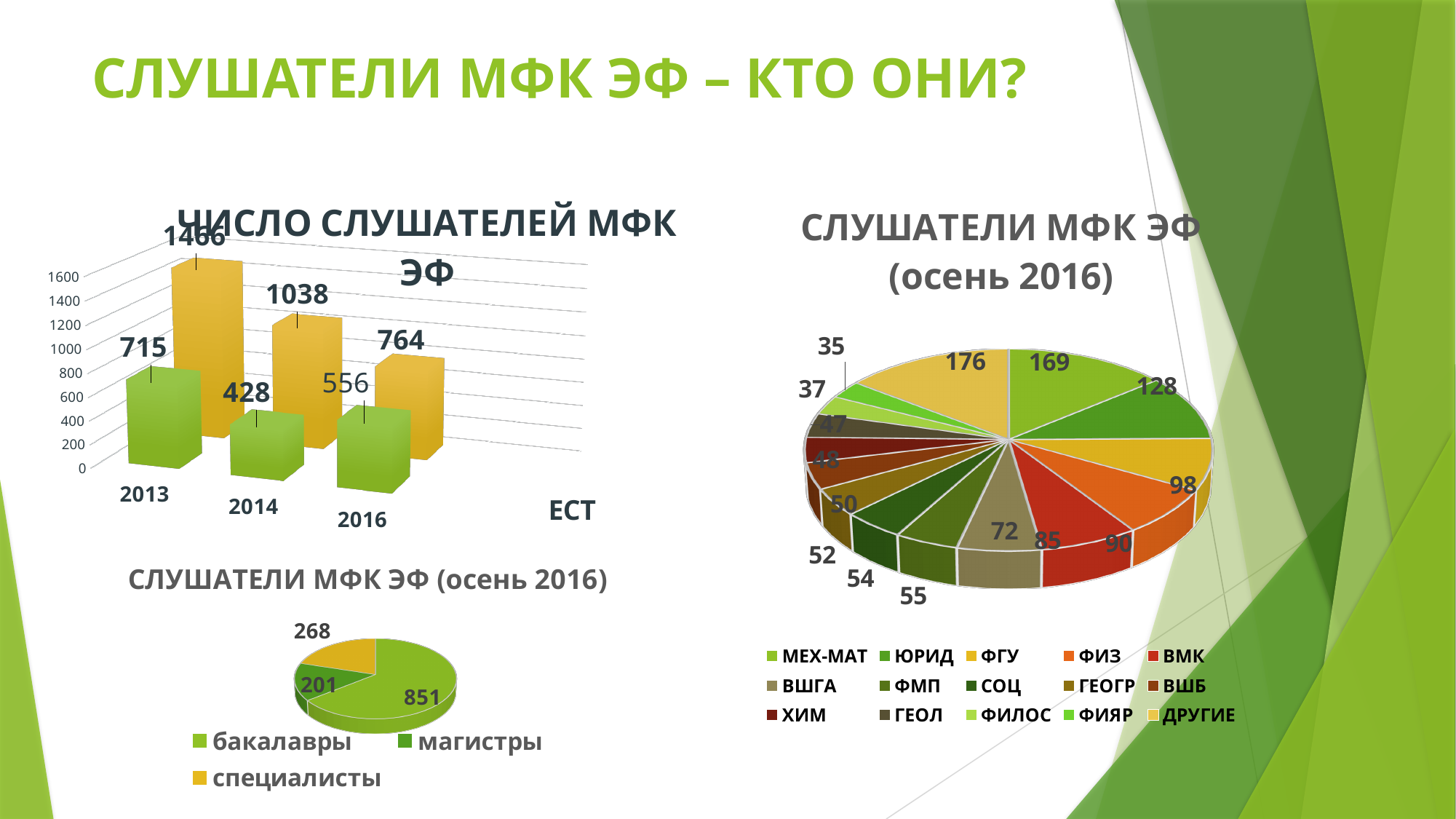
In the large pie chart on the right ('СЛУШАТЕЛИ МФК ЭФ (осень 2016)'), what is the value for МЕХ-МАТ? 169 In the small pie chart at the bottom left, how many categories does the legend list? 3 In the bar chart 'ЧИСЛО СЛУШАТЕЛЕЙ МФК ЭФ', what is the value of the green bar for 2014? 428 In the large pie chart on the right, how many categories does the legend list? 15 In the bar chart 'ЧИСЛО СЛУШАТЕЛЕЙ МФК ЭФ', how many years are shown on the x axis? 3 In the bar chart 'ЧИСЛО СЛУШАТЕЛЕЙ МФК ЭФ', which year has the highest yellow bar? 2013 In the bar chart 'ЧИСЛО СЛУШАТЕЛЕЙ МФК ЭФ', what is the value of the yellow bar for 2013? 1466 In the bar chart 'ЧИСЛО СЛУШАТЕЛЕЙ МФК ЭФ', what is the difference between the yellow bars for 2013 and 2016? 702 What kind of chart is 'ЧИСЛО СЛУШАТЕЛЕЙ МФК ЭФ'? bar chart In the small pie chart at the bottom left ('СЛУШАТЕЛИ МФК ЭФ (осень 2016)'), what is the value for бакалавры? 851 In the bar chart 'ЧИСЛО СЛУШАТЕЛЕЙ МФК ЭФ', do the yellow bars rise or fall from 2013 to 2016? fall In the small pie chart at the bottom left, which is larger: магистры or специалисты? специалисты